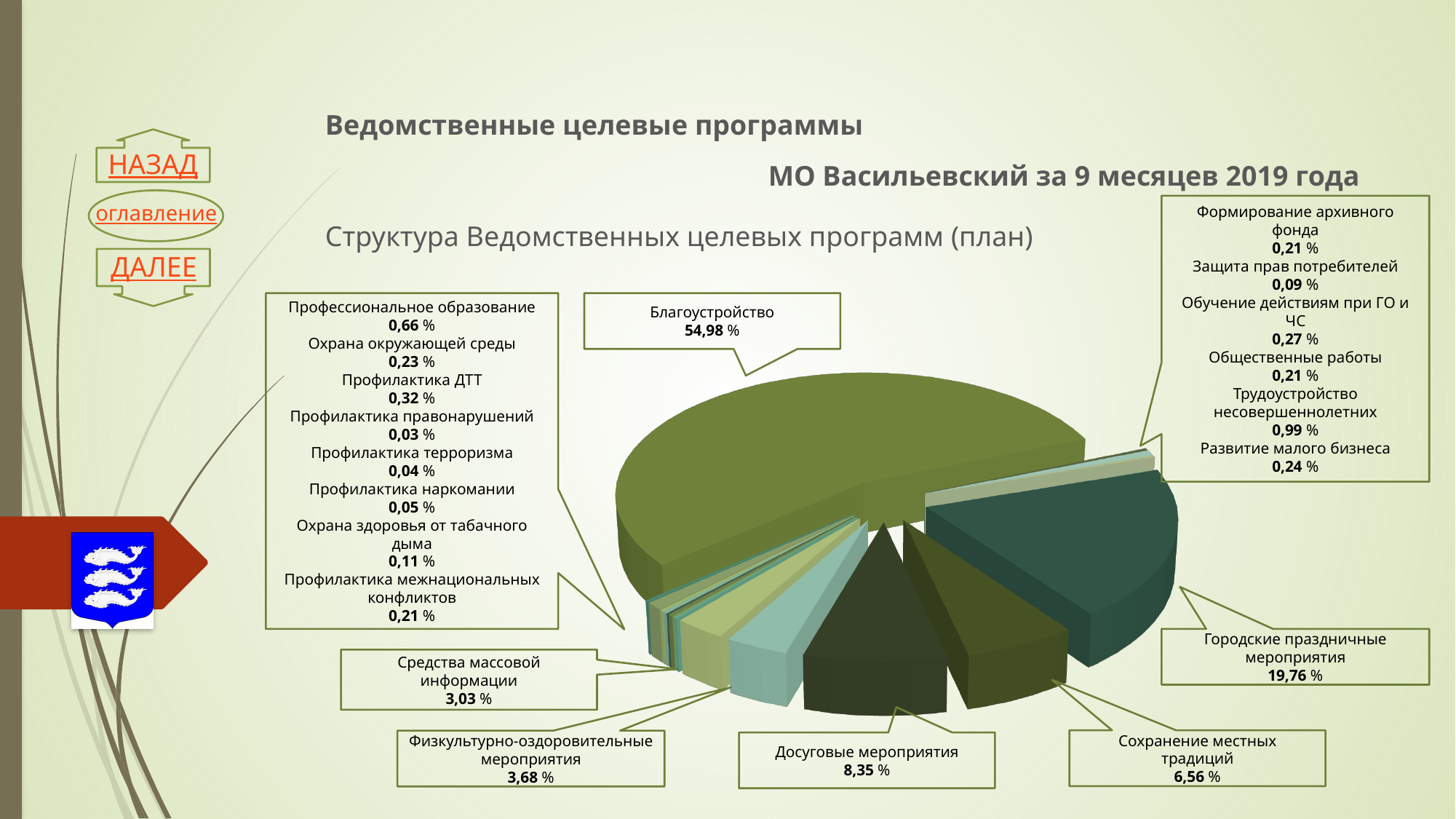
What type of chart is shown on the slide? Pie chart What is the difference between the shares of Благоустройство and Городские праздничные мероприятия? 35,22 % What is the value shown for Досуговые мероприятия? 8,35 % What is the title of the chart? Структура Ведомственных целевых программ (план) Which category has the largest share of the pie? Благоустройство Which is larger: Сохранение местных традиций or Досуговые мероприятия? Досуговые мероприятия What is the value shown for Трудоустройство несовершеннолетних? 0,99 % What share of the pie does Благоустройство account for? 54,98 % Which category has the smallest share of the pie? Профилактика правонарушений What is the value shown for Городские праздничные мероприятия? 19,76 % Which is larger: Физкультурно-оздоровительные мероприятия or Средства массовой информации? Физкультурно-оздоровительные мероприятия What is the value shown for Средства массовой информации? 3,03 %